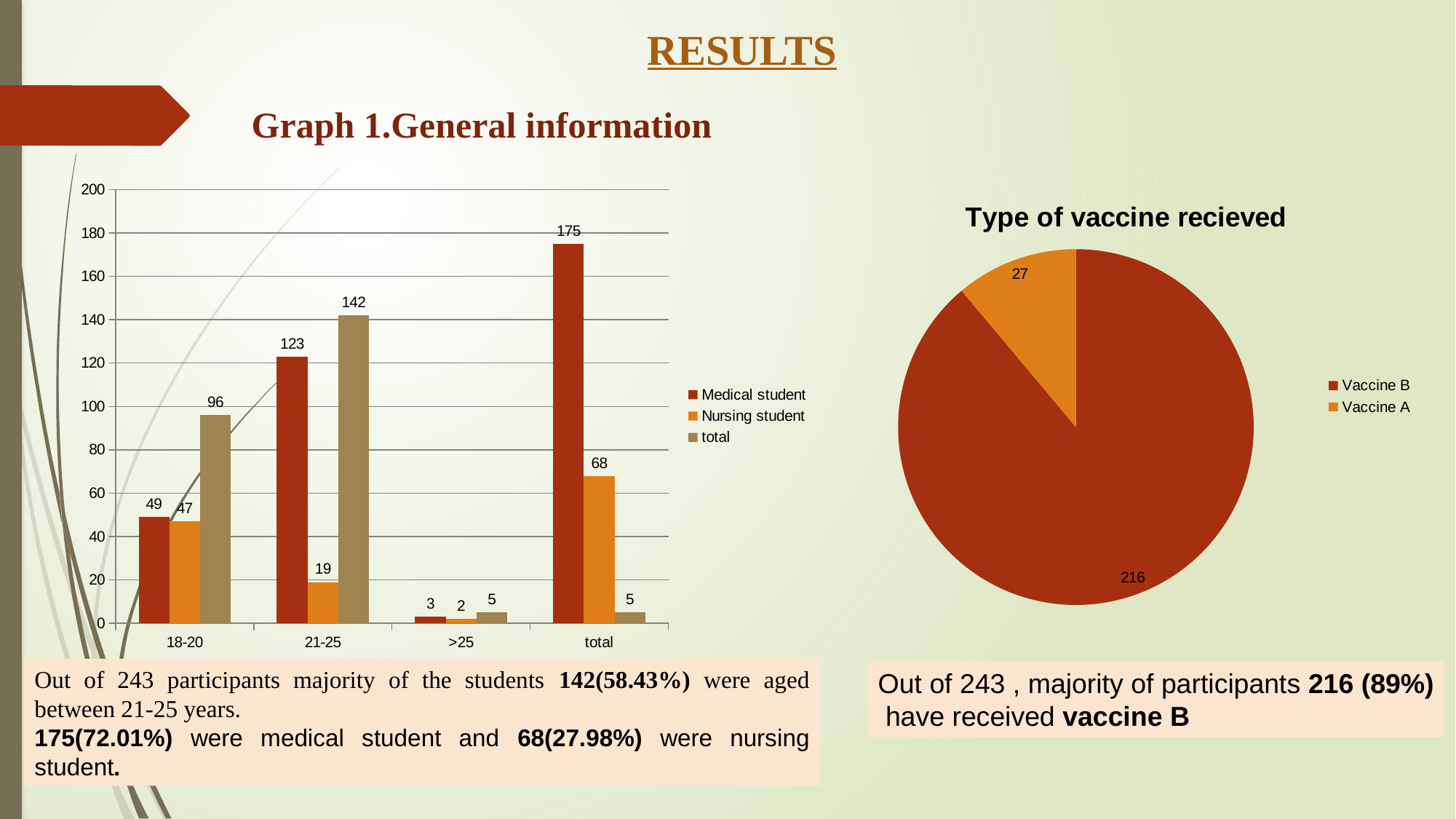
In the pie chart Type of vaccine recieved, what is the value for Vaccine A? 27 How many series does the legend of the bar chart Graph 1. General information list? 3 What kind of chart is the chart on the right of the slide, titled Type of vaccine recieved? Pie chart In the bar chart Graph 1. General information, what is the value for Nursing student in the 18-20 age group? 47 In the pie chart Type of vaccine recieved, which vaccine has the largest slice? Vaccine B In the bar chart Graph 1. General information, which age group has the highest total value? 21-25 In the bar chart Graph 1. General information, which is larger in the 18-20 age group: Medical student or Nursing student? Medical student In the bar chart Graph 1. General information, what is the total value for the >25 age group? 5 How many categories are shown on the x axis of the bar chart Graph 1. General information? 4 In the bar chart Graph 1. General information, what is the value for Medical student in the 21-25 age group? 123 In the bar chart Graph 1. General information, which age group has the lowest Medical student value? >25 In the bar chart Graph 1. General information, what is the difference between the Medical student and Nursing student values in the total category? 107